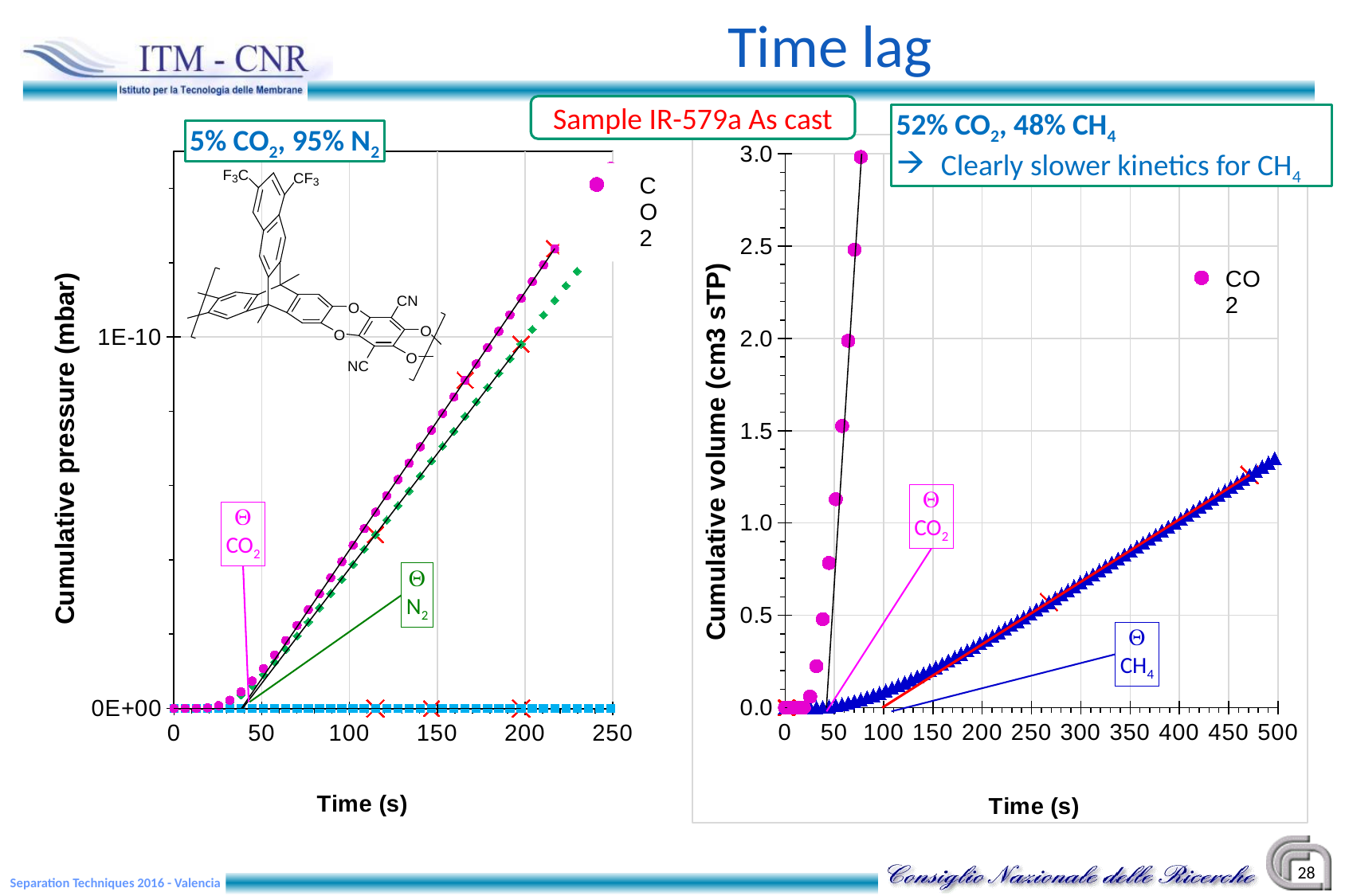
On the left chart (5% CO2, 95% N2), what is the highest value shown on the x axis? 250 What kind of chart is the left chart (5% CO2, 95% N2)? scatter chart On the right chart (52% CO2, 48% CH4), is the cumulative volume of CO2 at 75 s greater or less than 2.5? greater On the right chart (52% CO2, 48% CH4), what is the highest value shown on the x axis? 500 What is the y-axis label of the left chart (5% CO2, 95% N2)? Cumulative pressure (mbar) On the left chart (5% CO2, 95% N2), which gas shows the higher cumulative pressure at 200 s, CO2 or N2? CO2 On the left chart (5% CO2, 95% N2), does the cumulative pressure of CO2 rise or fall as time increases? rise On the right chart (52% CO2, 48% CH4), does the cumulative volume of CH4 rise or fall as time increases? rise What is the y-axis label of the right chart (52% CO2, 48% CH4)? Cumulative volume (cm3 sTP) On the right chart (52% CO2, 48% CH4), which gas reaches a higher cumulative volume, CO2 or CH4? CO2 On the right chart (52% CO2, 48% CH4), what is the highest value shown on the y axis? 3.0 On the right chart (52% CO2, 48% CH4), is the cumulative volume of CH4 at 500 s greater or less than 1.5? less